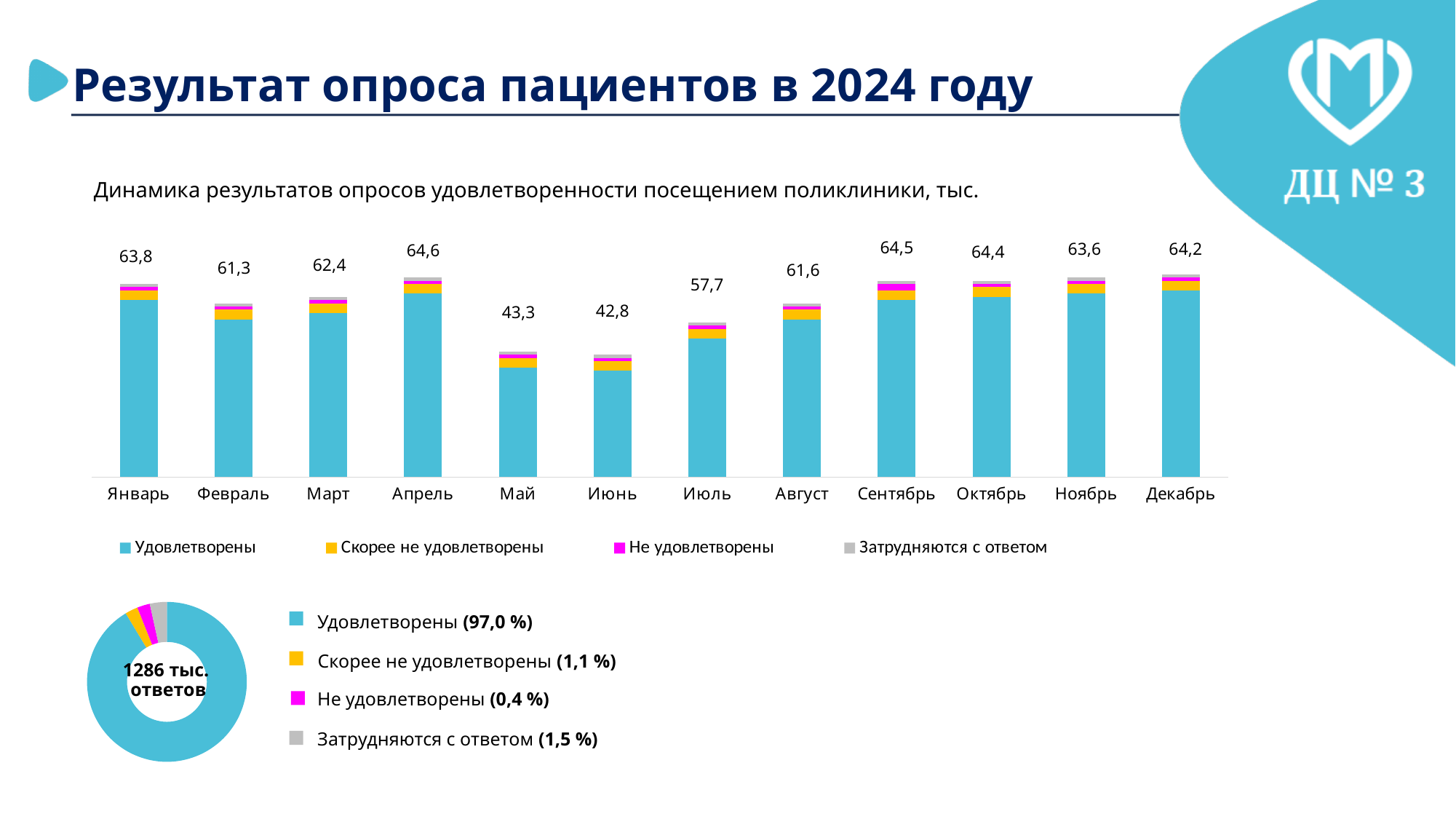
In the donut chart at the bottom, what share is shown for Затрудняются с ответом? 1,5 % In the upper bar chart, which month has the larger labelled total, Январь or Февраль? Январь How many months (categories) are shown on the x axis of the upper bar chart? 12 In the upper bar chart, what is the difference between the labelled totals for Апрель and Май? 21,3 In the upper bar chart, which month has the highest labelled total? Апрель In the upper bar chart, what is the total value labelled for Июль? 57,7 In the upper bar chart, what is the total value labelled for Апрель? 64,6 What kind of chart is the upper chart showing monthly survey results? Stacked bar chart In the donut chart at the bottom, what share is shown for Удовлетворены? 97,0 % How many series does the legend of the upper bar chart list? 4 What total number of responses is written in the centre of the donut chart? 1286 тыс. ответов In the upper bar chart, which month has the lowest labelled total? Июнь